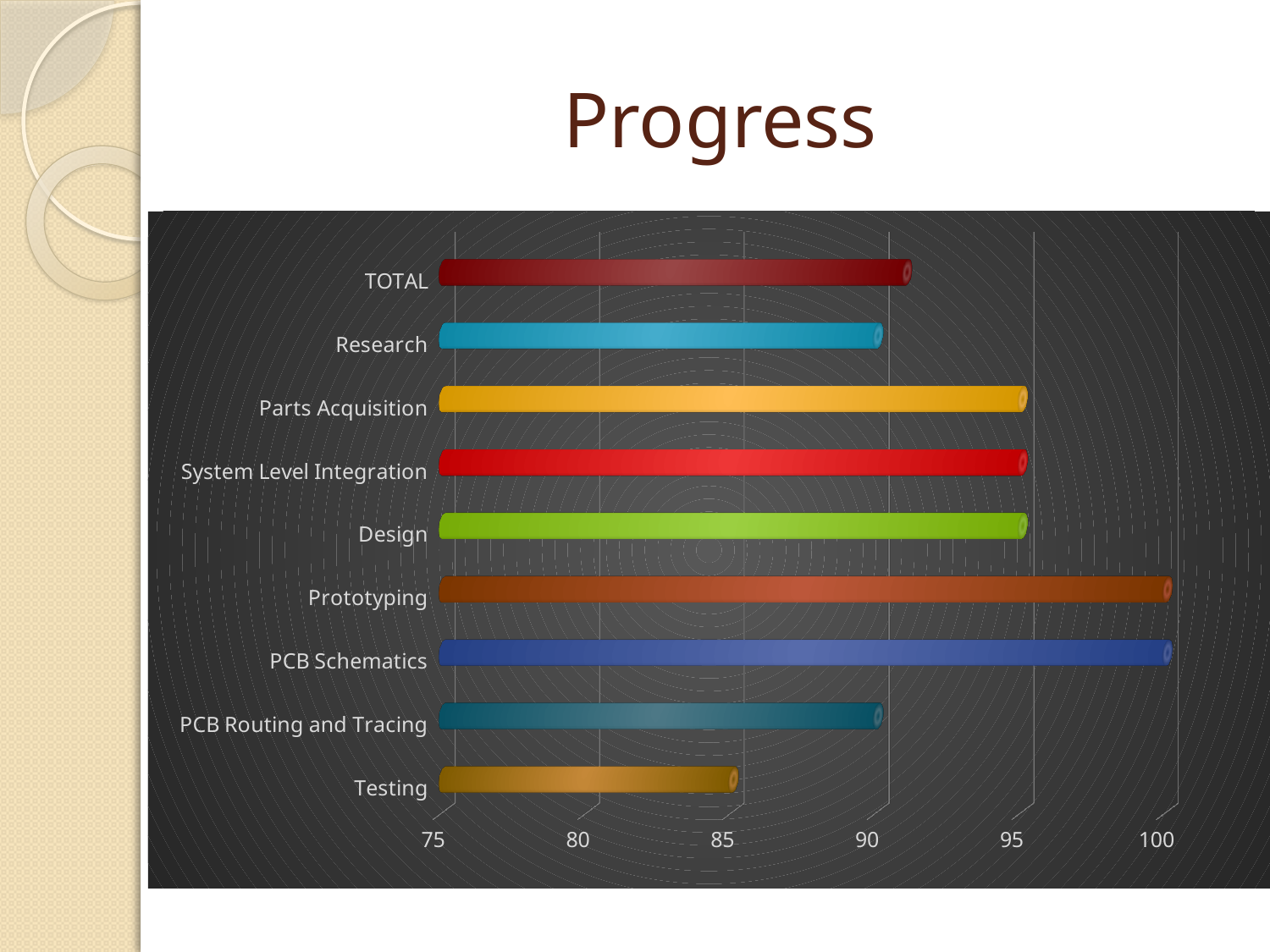
Which is larger, the value for Design or the value for Research? Design Is the value for TOTAL greater or less than 95? less Which is larger, the value for Parts Acquisition or the value for Testing? Parts Acquisition What kind of chart is shown on the slide? bar chart What is the title of the chart? Progress How many categories are plotted in the chart? 9 What is the value for Design? 95 Is the value for PCB Schematics greater or less than 95? greater What is the value for Prototyping? 100 Is the value for Testing greater or less than 90? less What is the value for Testing? 85 Which category has the lowest value? Testing